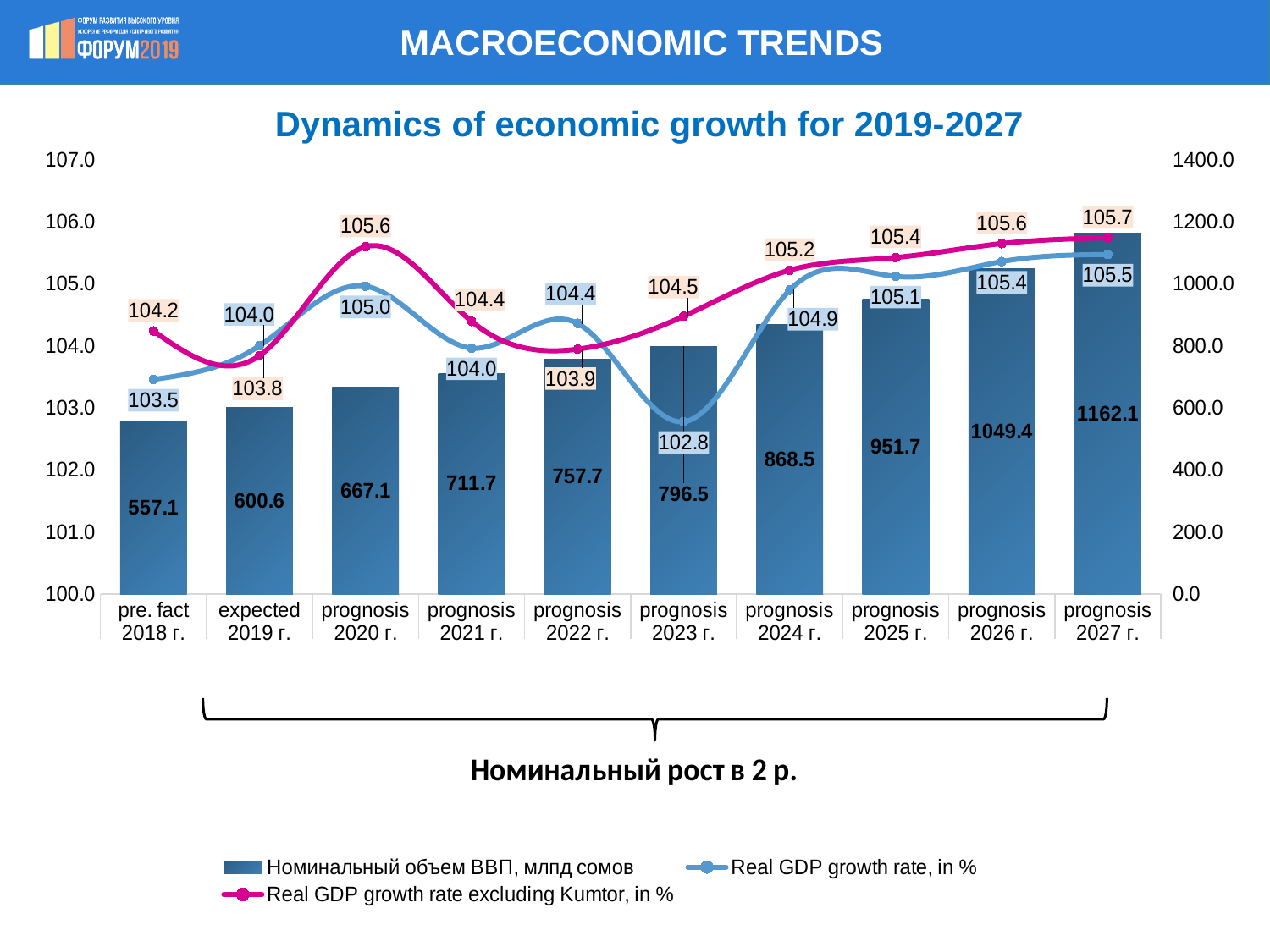
Does the nominal GDP volume rise or fall from 2018 to 2027? Rise What is the nominal GDP volume (Номинальный объем ВВП, млрд сомов) for prognosis 2023 г.? 796.5 How many year categories are shown on the x axis? 10 What type of chart is this? Combination bar and line chart What is the Real GDP growth rate, in %, for prognosis 2020 г.? 105.0 What is the difference between the Real GDP growth rate excluding Kumtor and the Real GDP growth rate for prognosis 2024 г.? 0.3 By how much does the nominal GDP volume for prognosis 2027 г. exceed that for pre. fact 2018 г.? 605.0 For prognosis 2020 г., which is higher: the Real GDP growth rate or the Real GDP growth rate excluding Kumtor? Real GDP growth rate excluding Kumtor Which year has the highest nominal GDP volume bar? prognosis 2027 г. What is the Real GDP growth rate excluding Kumtor, in %, for prognosis 2022 г.? 103.9 In which year is the Real GDP growth rate, in %, at its lowest? prognosis 2023 г. How many series does the legend list? 3